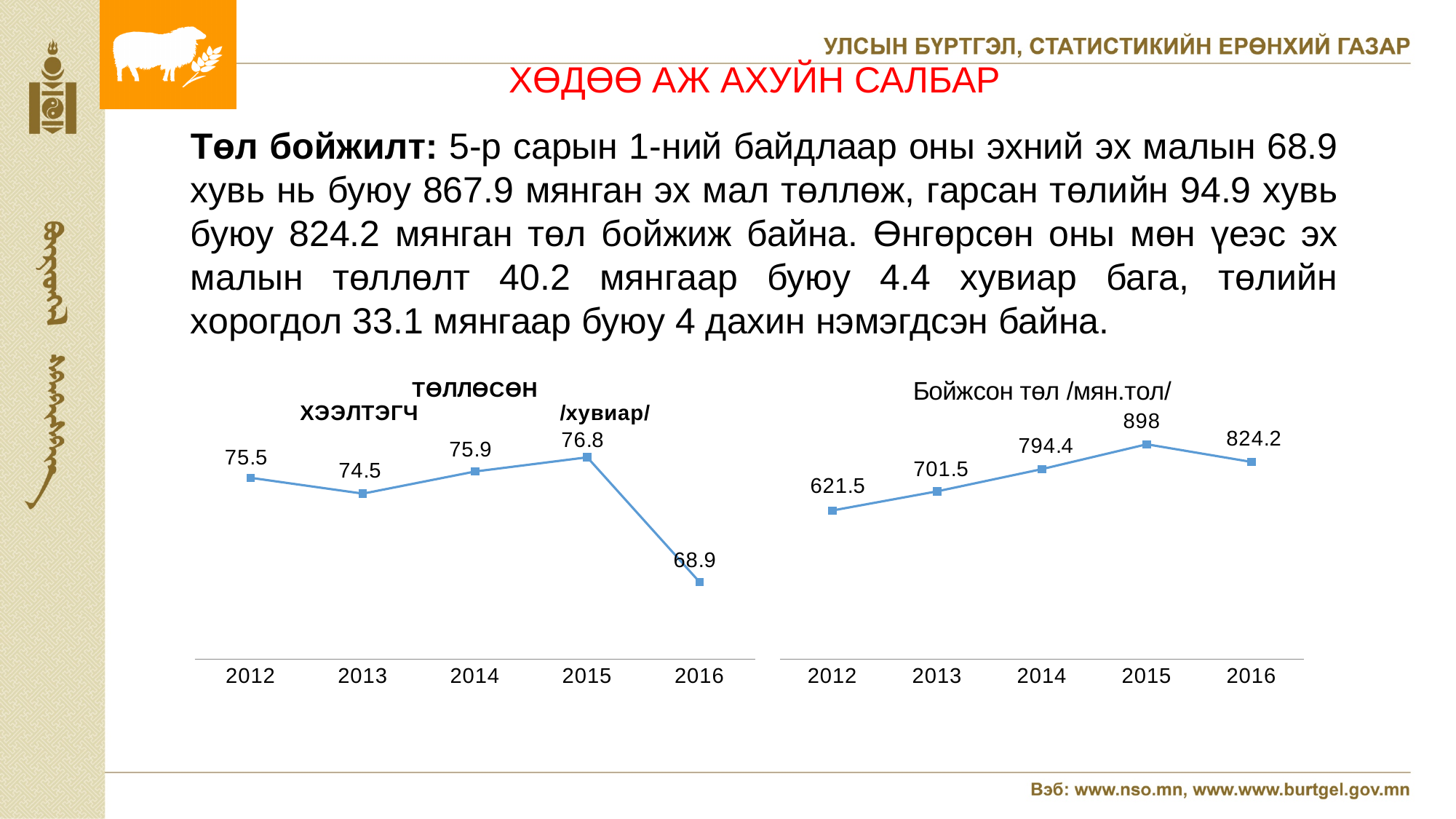
In the right chart (Бойжсон төл /мян.тол/), what is the value for 2014? 794.4 In the left chart (Хээлтэгч төллөсөн /хувиар/), what is the value for 2015? 76.8 In the right chart (Бойжсон төл /мян.тол/), which year has the highest value? 2015 In the right chart (Бойжсон төл /мян.тол/), which is larger, the value for 2013 or the value for 2016? 2016 In the left chart (Хээлтэгч төллөсөн /хувиар/), what is the value for 2013? 74.5 What type of chart is the right chart (Бойжсон төл /мян.тол/)? Line chart In the left chart (Хээлтэгч төллөсөн /хувиар/), which year has the lowest value? 2016 How many data points are plotted in the left chart (Хээлтэгч төллөсөн /хувиар/)? 5 In the left chart (Хээлтэгч төллөсөн /хувиар/), what is the difference between the 2015 and 2016 values? 7.9 In the right chart (Бойжсон төл /мян.тол/), what is the value for 2012? 621.5 In the right chart (Бойжсон төл /мян.тол/), what is the difference between the 2015 and 2016 values? 73.8 In the right chart (Бойжсон төл /мян.тол/), do the values rise or fall from 2012 to 2015? Rise